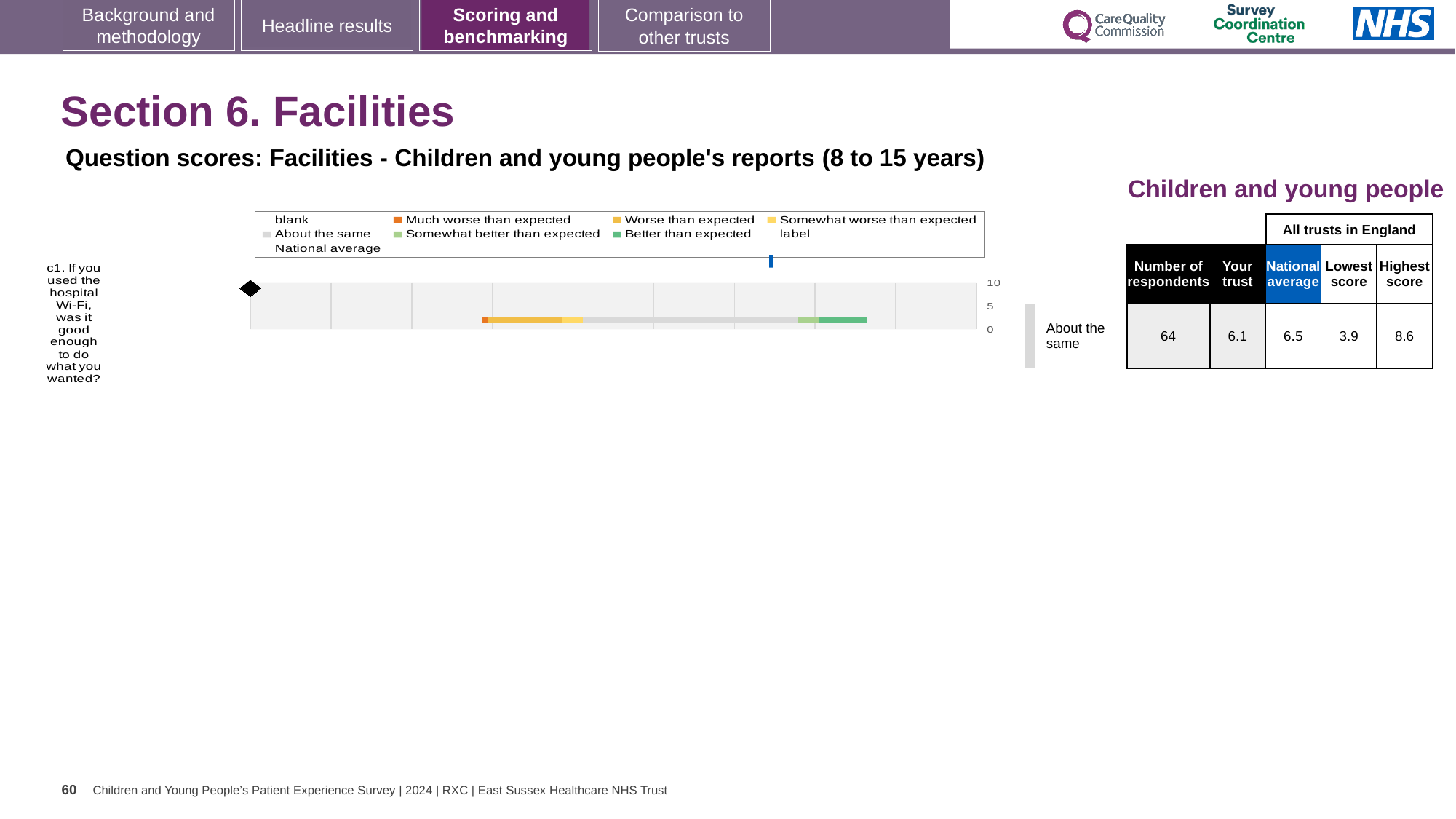
According to the table beside the chart, what is the Highest score among all trusts in England for question c1? 8.6 How many survey questions are plotted in the chart? 1 What kind of chart is shown on the slide? bar chart Which is larger for question c1: the Your trust score or the National average score? National average According to the table beside the chart, what is the Lowest score among all trusts in England for question c1? 3.9 What is the highest value shown on the chart's axis? 10 What is the difference between the Highest score and the Lowest score for question c1? 4.7 What is the difference between the National average score and the Your trust score for question c1? 0.4 Which survey question is plotted in the chart? c1. If you used the hospital Wi-Fi, was it good enough to do what you wanted? How many respondents answered question c1, according to the table beside the chart? 64 According to the table beside the chart, what is the score for Your trust on question c1? 6.1 According to the table beside the chart, what is the National average score for question c1? 6.5